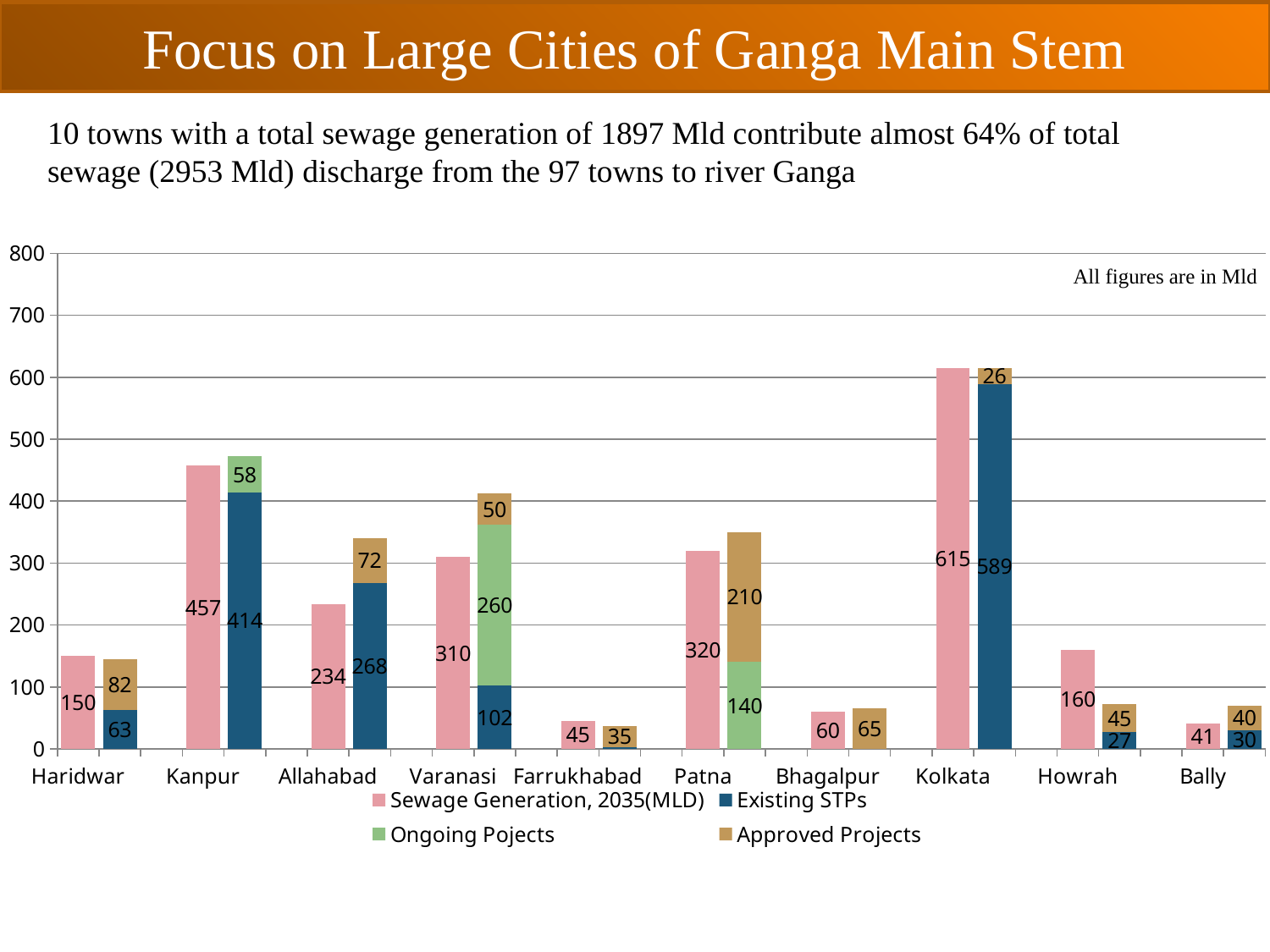
How many cities are shown on the x axis of the chart? 10 What is the difference between the Sewage Generation, 2035(MLD) value and the Existing STPs value for Kolkata? 26 Is the Sewage Generation, 2035(MLD) value for Howrah greater or less than 200? less What is the Existing STPs value for Kanpur? 414 For Allahabad, which is larger: the Sewage Generation, 2035(MLD) value or the Existing STPs value? Existing STPs Which city has the highest Sewage Generation, 2035(MLD) value? Kolkata How many series does the chart legend list? 4 What is the Approved Projects value for Patna? 210 What kind of chart is shown on the slide? Bar chart What is the total of the stacked bar (Existing STPs, Ongoing Pojects and Approved Projects) for Varanasi? 412 What is the Sewage Generation, 2035(MLD) value for Kolkata? 615 Which city has the lowest Sewage Generation, 2035(MLD) value? Bally